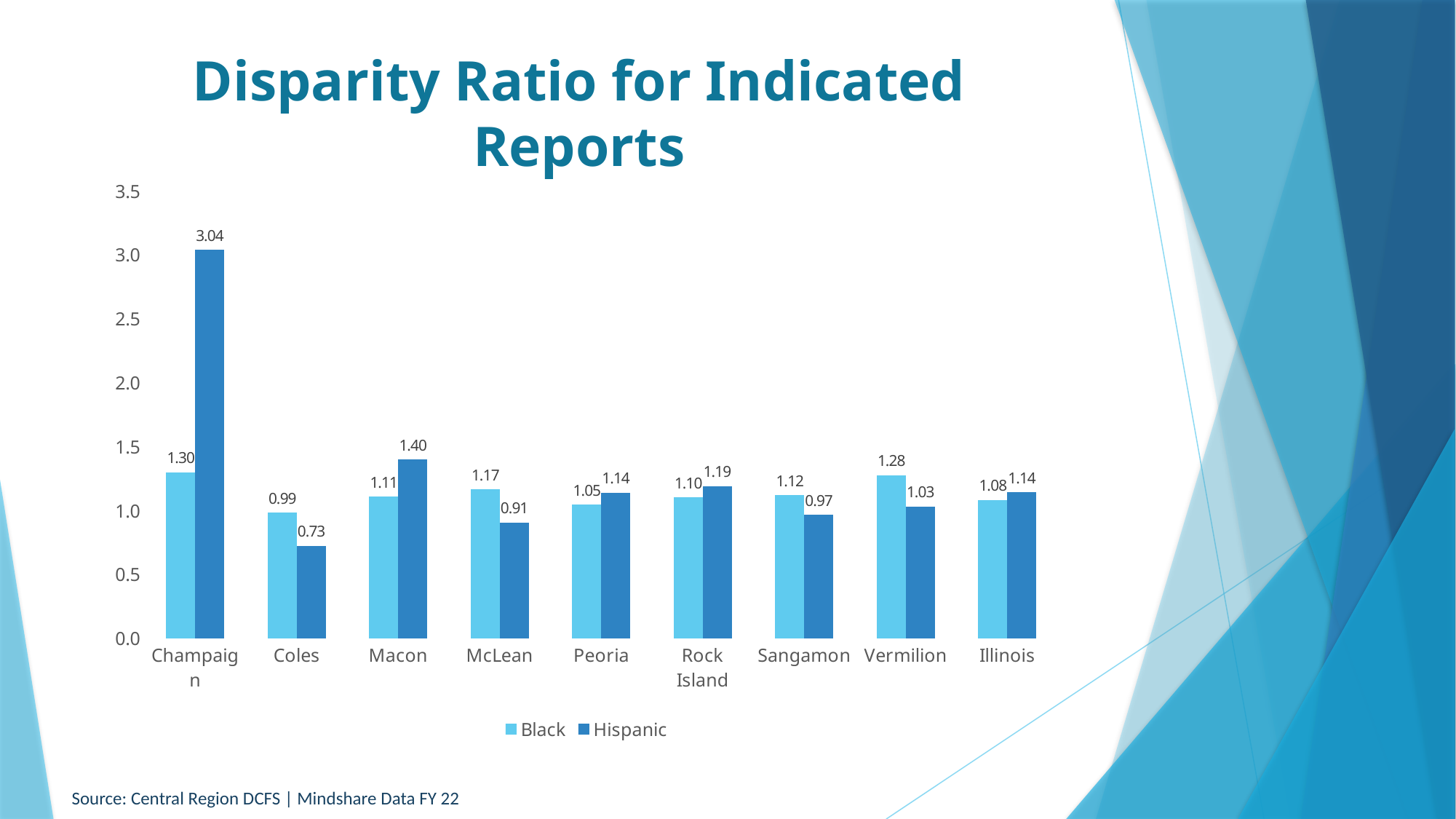
How many categories are shown on the x axis? 9 Is the Hispanic value for Champaign greater or less than 3.0? greater What is the Black disparity ratio for Vermilion? 1.28 What is the Hispanic disparity ratio for Champaign? 3.04 What kind of chart is shown on the slide? Bar chart What is the Hispanic disparity ratio for Coles? 0.73 Which is larger for McLean, the Black or the Hispanic disparity ratio? Black Which category has the lowest Black disparity ratio? Coles What is the title of the chart? Disparity Ratio for Indicated Reports Which category has the highest Hispanic disparity ratio? Champaign What is the difference between the Hispanic and Black disparity ratios for Champaign? 1.74 How many series does the legend list? 2